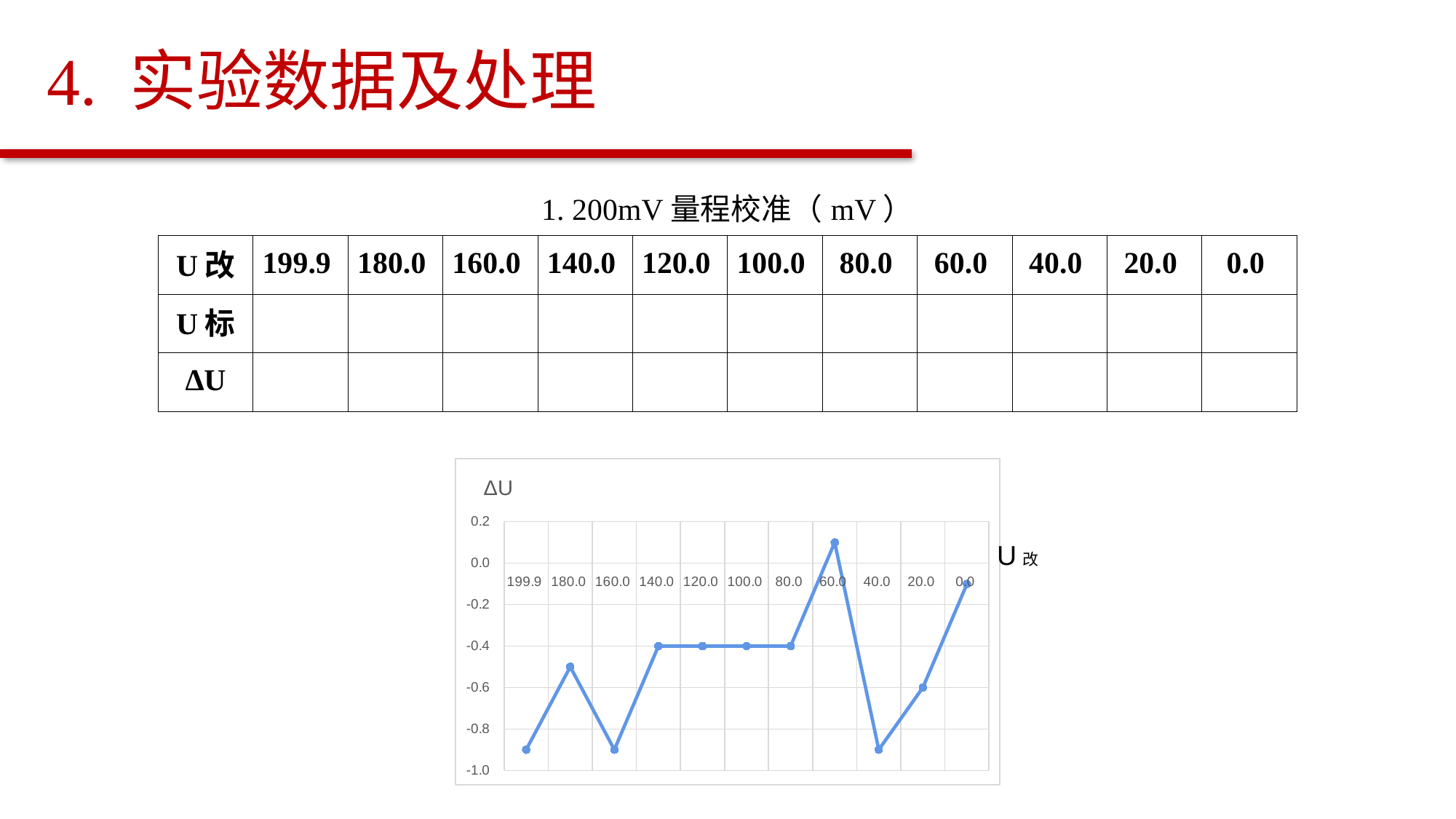
What is the ΔU value at U改 = 100.0? -0.4 Which has the larger ΔU value, U改 = 180.0 or U改 = 160.0? 180.0 What is the ΔU value at U改 = 140.0? -0.4 At which U改 value is ΔU highest? 60.0 What kind of chart is shown on the slide? line chart What is the label on the vertical axis of the chart? ΔU Is the ΔU value at U改 = 0.0 greater or less than -0.2? greater Does the line rise or fall from U改 = 60.0 to U改 = 40.0? fall How many data points are plotted on the ΔU chart? 11 What is the ΔU value at U改 = 20.0? -0.6 Is the ΔU value at U改 = 199.9 greater or less than -0.8? less Is the ΔU value at U改 = 60.0 greater or less than 0.0? greater